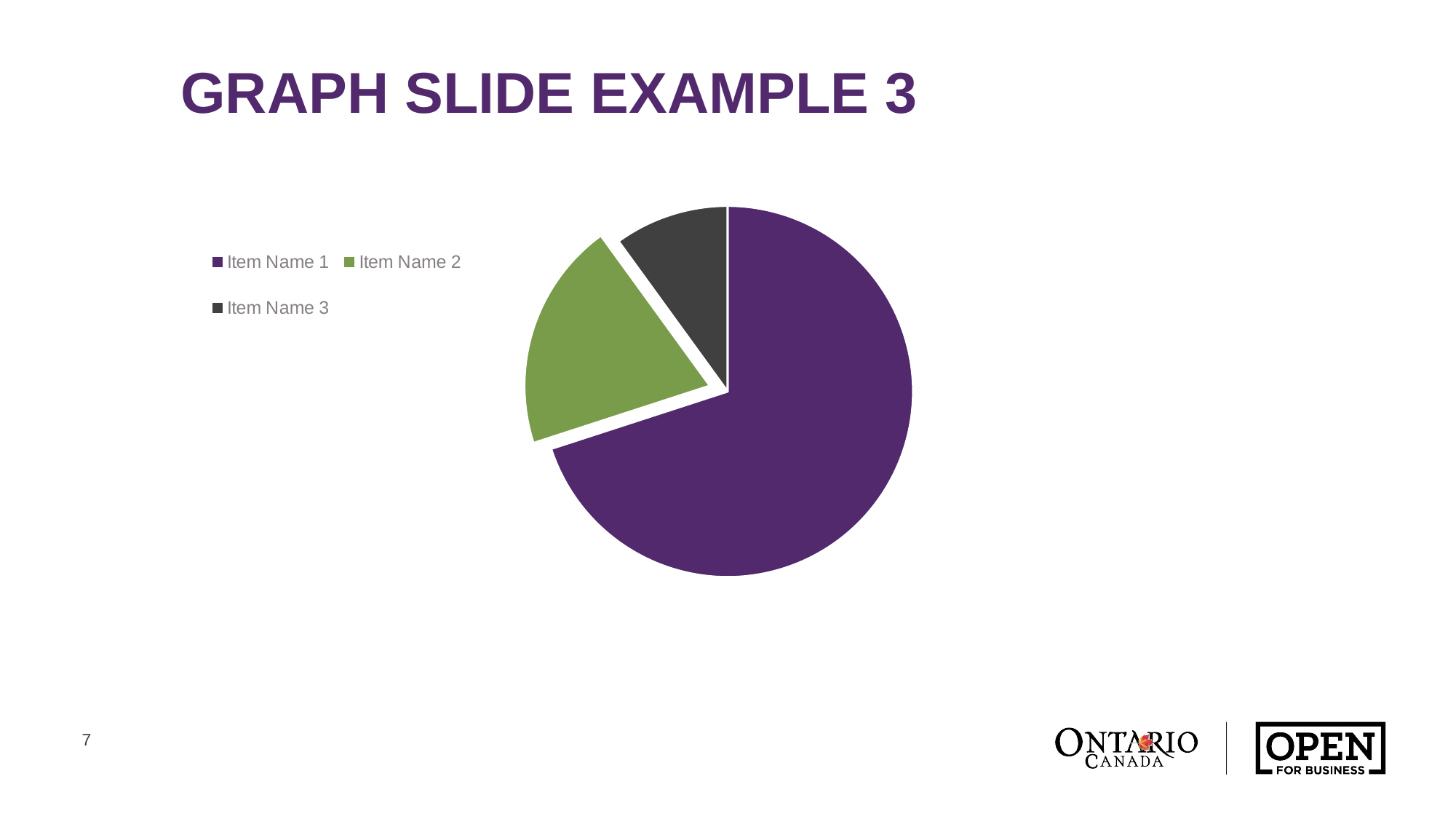
How many entries does the legend of the pie chart list? 3 Which item has the largest slice in the pie chart? Item Name 1 Which item has the smallest slice in the pie chart? Item Name 3 What kind of chart is shown on the slide? pie chart What colour is the slice for Item Name 2 in the pie chart? green Which slice is larger in the pie chart, Item Name 2 or Item Name 3? Item Name 2 Does Item Name 1 account for more or less than half of the pie chart? more How many slices does the pie chart have? 3 Which slice is larger in the pie chart, Item Name 1 or Item Name 2? Item Name 1 What colour is the slice for Item Name 1 in the pie chart? purple